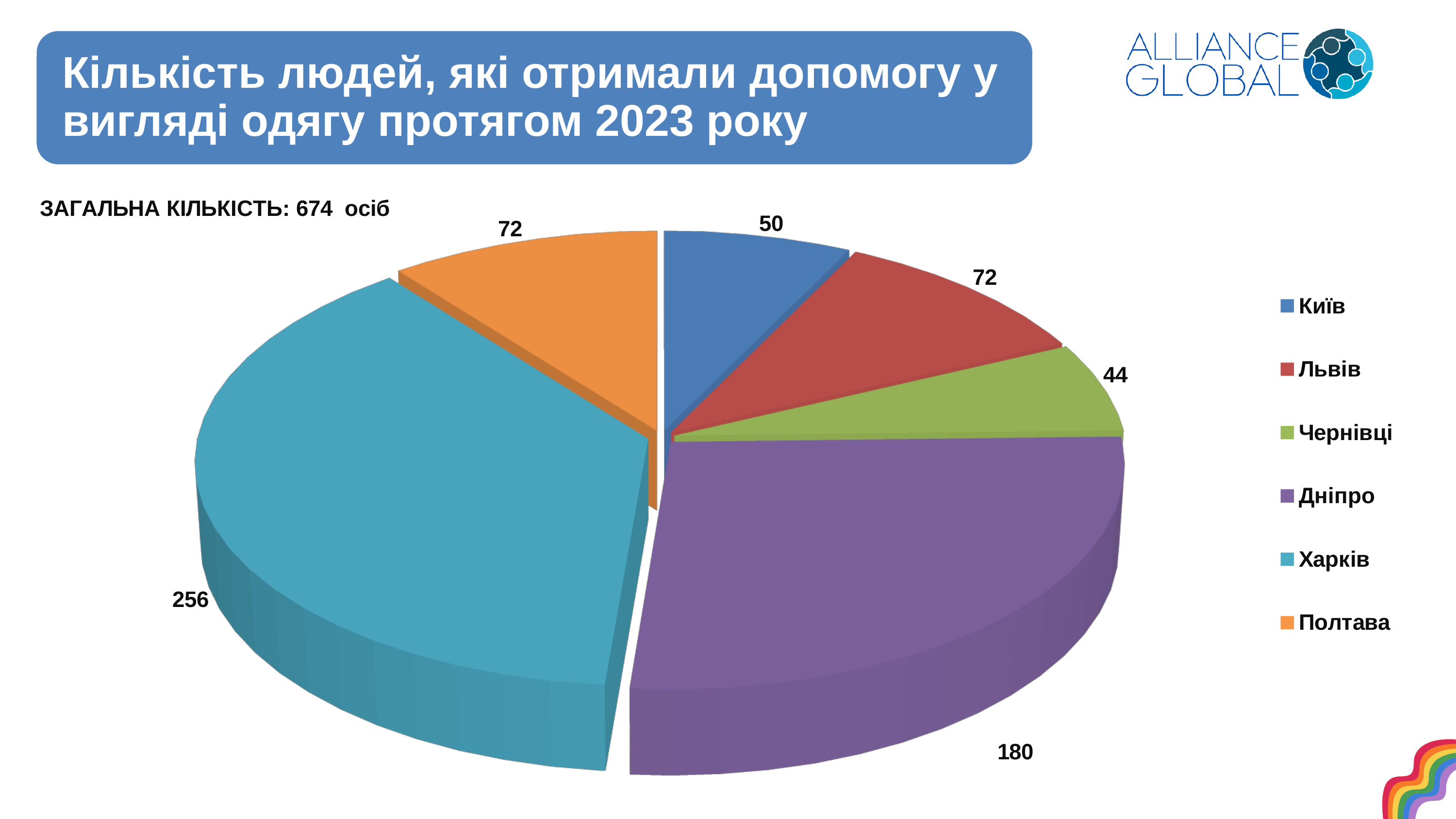
Which is larger, the value for Львів or the value for Київ? Львів What value is shown for Чернівці in the pie chart? 44 What type of chart is shown on the slide? Pie chart What is the difference between the values for Дніпро and Київ? 130 Which city has the largest slice in the pie chart? Харків What is the difference between the values for Харків and Дніпро? 76 What colour represents Полтава in the pie chart legend? Orange What is the total number of people shown on the slide (ЗАГАЛЬНА КІЛЬКІСТЬ)? 674 What value is shown for the Дніпро slice of the pie chart? 180 How many people received clothing assistance in Київ according to the pie chart? 50 Which city has the smallest slice in the pie chart? Чернівці How many cities are shown in the pie chart? 6